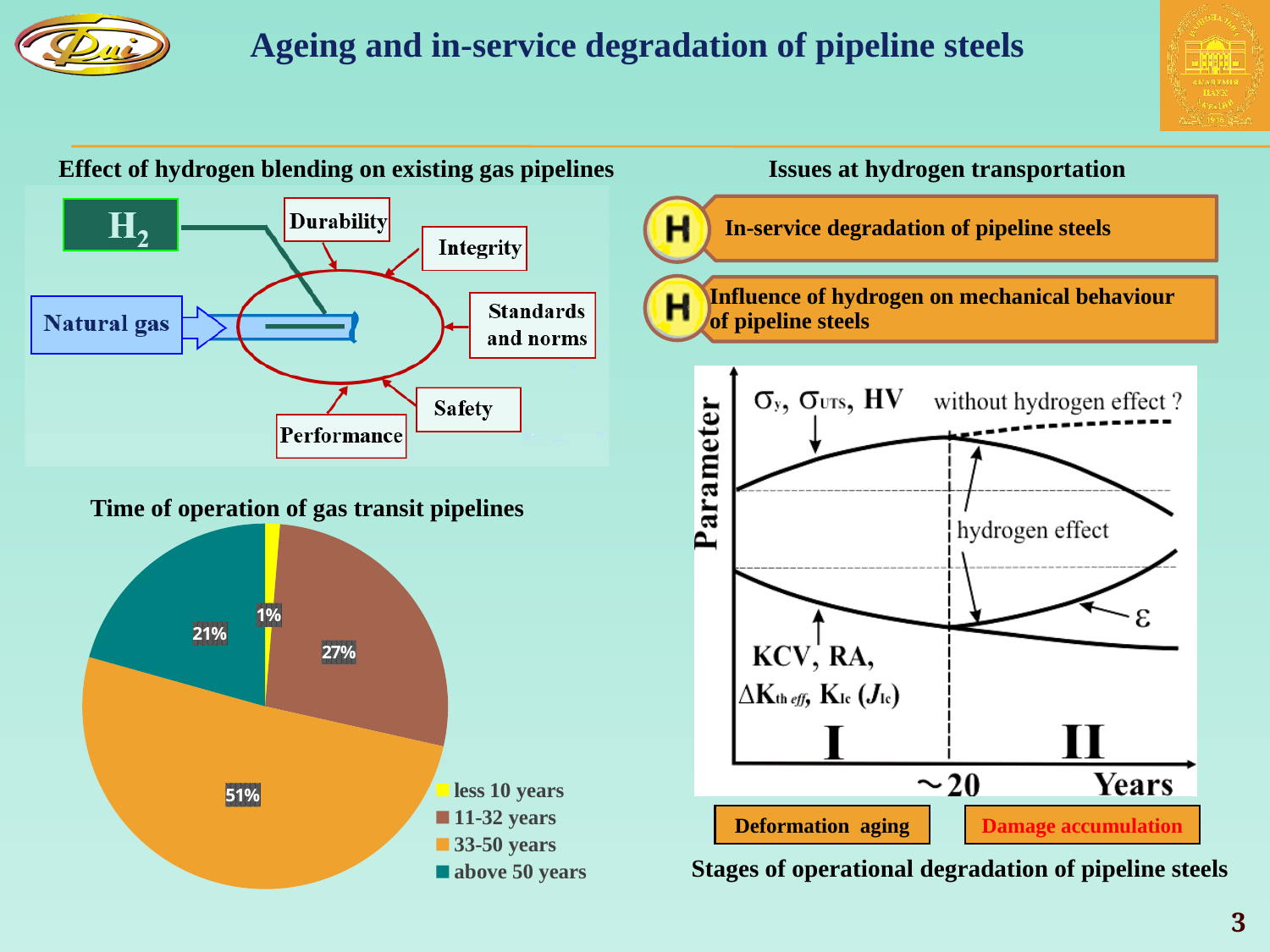
In the 'Time of operation of gas transit pipelines' chart, what colour is the slice for above 50 years? Teal In the 'Time of operation of gas transit pipelines' chart, what share of pipelines have operated for above 50 years? 21% In the 'Time of operation of gas transit pipelines' chart, which category has the largest share? 33-50 years In the 'Time of operation of gas transit pipelines' chart, which is larger: the share for 11-32 years or the share for above 50 years? 11-32 years In the 'Time of operation of gas transit pipelines' chart, what is the difference in percentage points between the 33-50 years slice and the 11-32 years slice? 24 In the 'Time of operation of gas transit pipelines' chart, what share of pipelines have operated for 33-50 years? 51% In the 'Time of operation of gas transit pipelines' chart, what is the combined share of pipelines that have operated for more than 32 years (33-50 years plus above 50 years)? 72% In the 'Time of operation of gas transit pipelines' chart, what share of pipelines have operated for 11-32 years? 27% What kind of chart is 'Time of operation of gas transit pipelines'? Pie chart In the 'Time of operation of gas transit pipelines' chart, what share of pipelines have operated for less than 10 years? 1% In the 'Time of operation of gas transit pipelines' chart, which category has the smallest share? less 10 years How many categories does the 'Time of operation of gas transit pipelines' chart show? 4